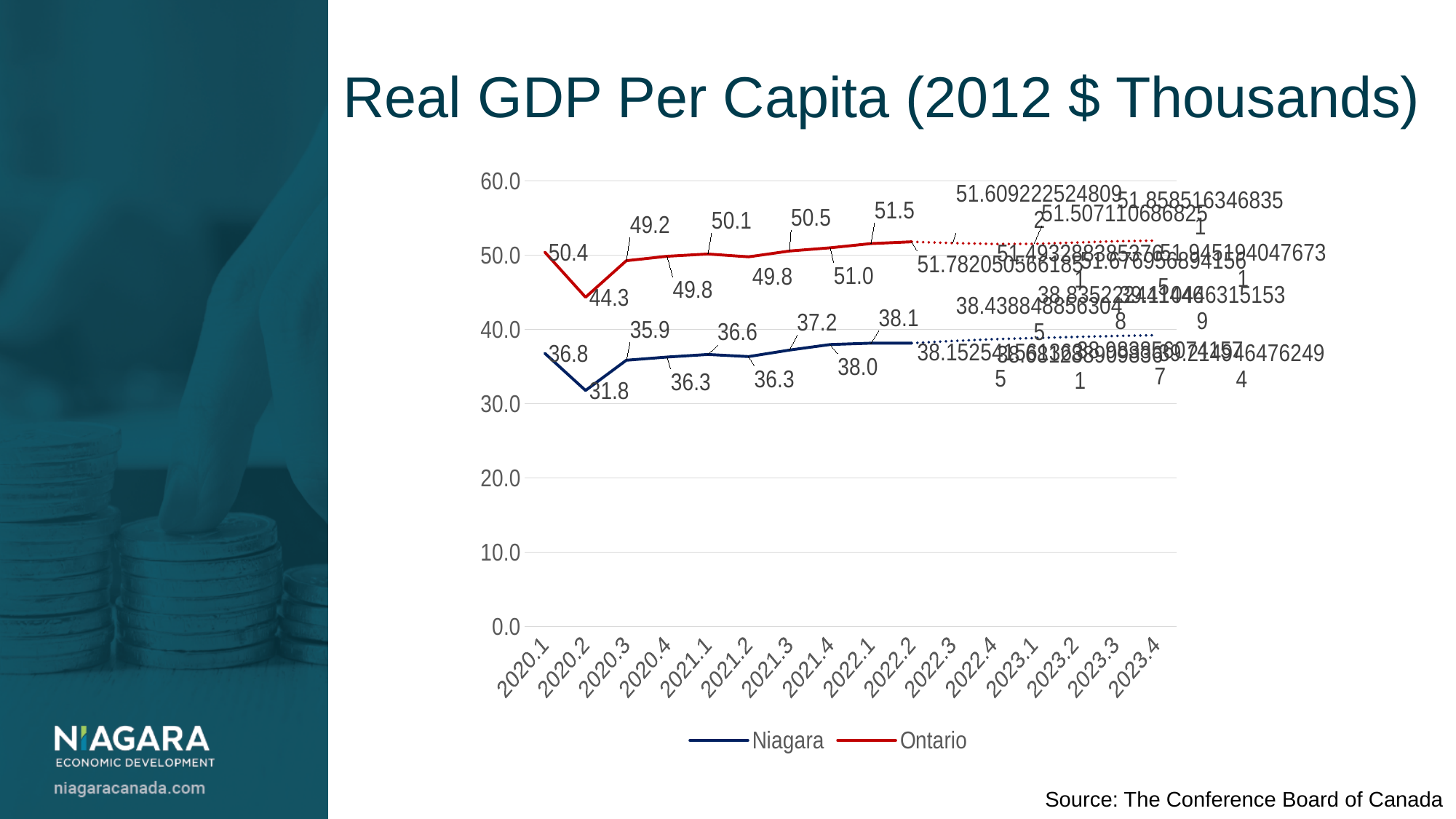
How many quarters are shown on the x axis? 16 Which series has the higher value in 2021.3, Niagara or Ontario? Ontario What kind of chart is shown on the slide? line chart How many series does the legend list? 2 In which quarter is the Ontario series at its lowest? 2020.2 Is the Niagara value for 2022.1 greater or less than 40.0? less What is the Niagara value for 2020.2? 31.8 In which quarter is the Niagara series at its lowest? 2020.2 What is the difference between the Niagara values for 2020.1 and 2020.2? 5.0 What is the Ontario value for 2020.1? 50.4 What is the difference between the Ontario values for 2020.1 and 2020.2? 6.1 What is the Niagara value for 2021.4? 38.0